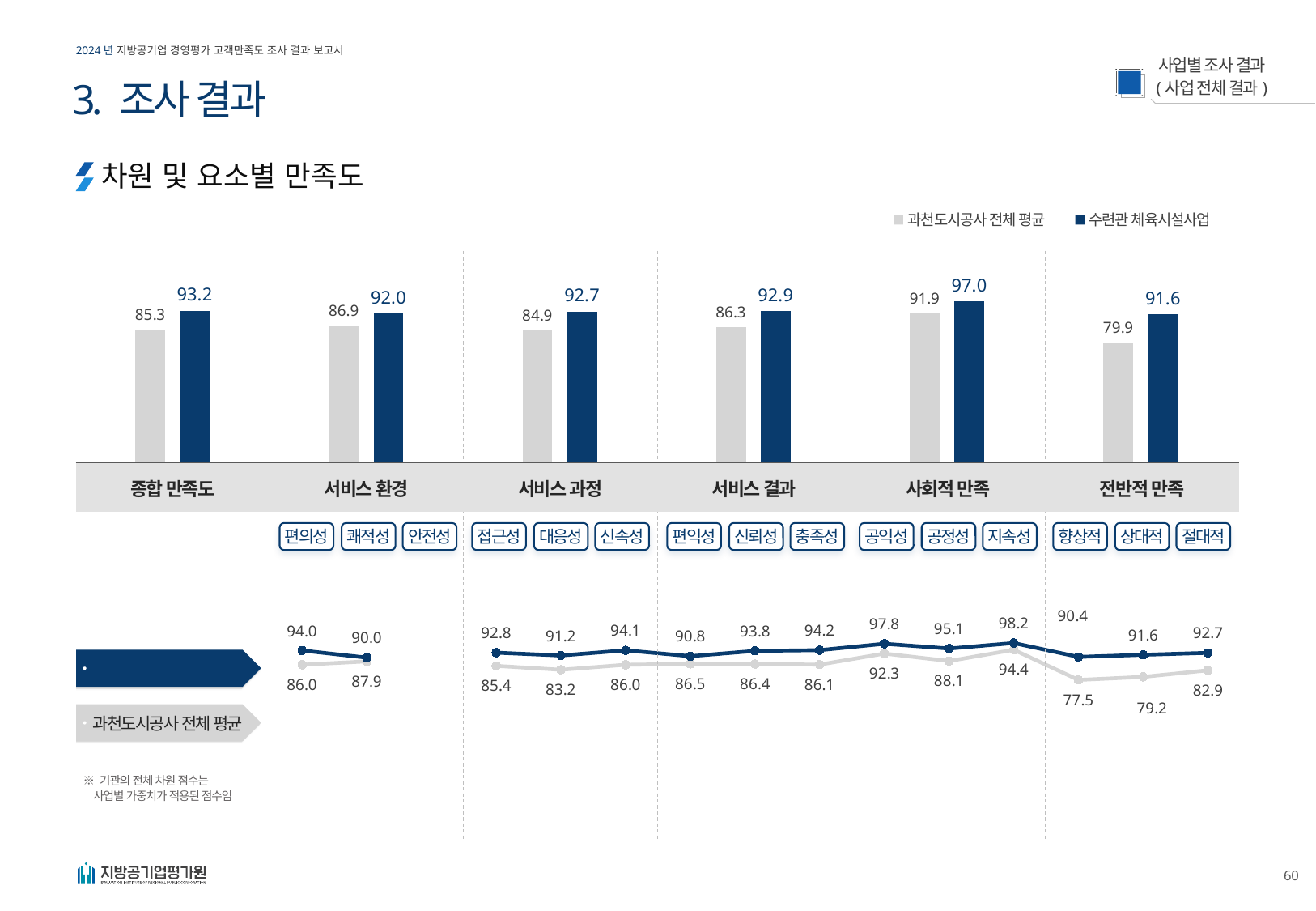
In the top bar chart, which category has the lowest value for 과천도시공사 전체 평균? 전반적 만족 In the bottom line chart, which is larger for 대응성: the 수련관 체육시설사업 value or the 과천도시공사 전체 평균 value? 수련관 체육시설사업 In the bottom line chart, what is the 수련관 체육시설사업 value for 지속성? 98.2 How many series does the legend of the top bar chart list? 2 In the top bar chart, what is the difference between 수련관 체육시설사업 and 과천도시공사 전체 평균 for 종합 만족도? 7.9 In the top bar chart, how many categories are shown on the x axis? 6 In the top bar chart, what is the value for 과천도시공사 전체 평균 in 전반적 만족? 79.9 In the top bar chart, what is the value for 수련관 체육시설사업 in 사회적 만족? 97.0 In the bottom line chart, what is the 과천도시공사 전체 평균 value for 향상적? 77.5 What kind of chart is the top chart on the slide? bar chart In the bottom line chart, what is the difference between the 수련관 체육시설사업 and 과천도시공사 전체 평균 values for 상대적? 12.4 In the top bar chart, which category has the highest value for 수련관 체육시설사업? 사회적 만족